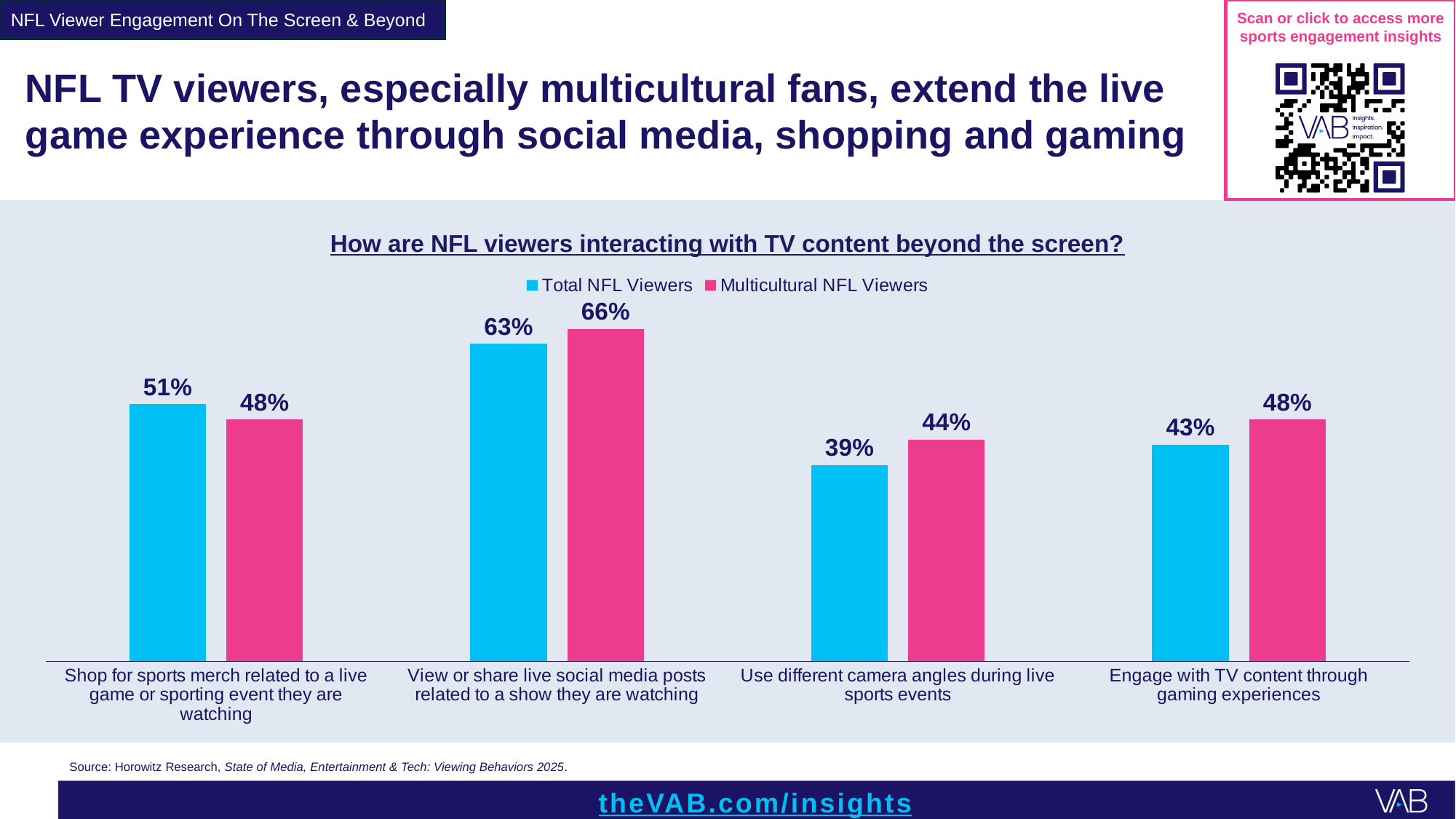
For shopping for sports merch related to a live game, which is larger: Total NFL Viewers or Multicultural NFL Viewers? Total NFL Viewers How many series does the chart legend list? 2 What kind of chart is shown on the slide? Bar chart What percentage of Total NFL Viewers shop for sports merch related to a live game or sporting event they are watching? 51% What is the value for Multicultural NFL Viewers who engage with TV content through gaming experiences? 48% What is the value for Total NFL Viewers who use different camera angles during live sports events? 39% What percentage of Multicultural NFL Viewers view or share live social media posts related to a show they are watching? 66% What colour represents Multicultural NFL Viewers in the chart? Pink Which category has the highest value for Total NFL Viewers? View or share live social media posts related to a show they are watching What is the difference between Multicultural NFL Viewers and Total NFL Viewers for using different camera angles during live sports events? 5% How many categories are shown on the x axis of the chart? 4 Which category has the lowest value for Multicultural NFL Viewers? Use different camera angles during live sports events